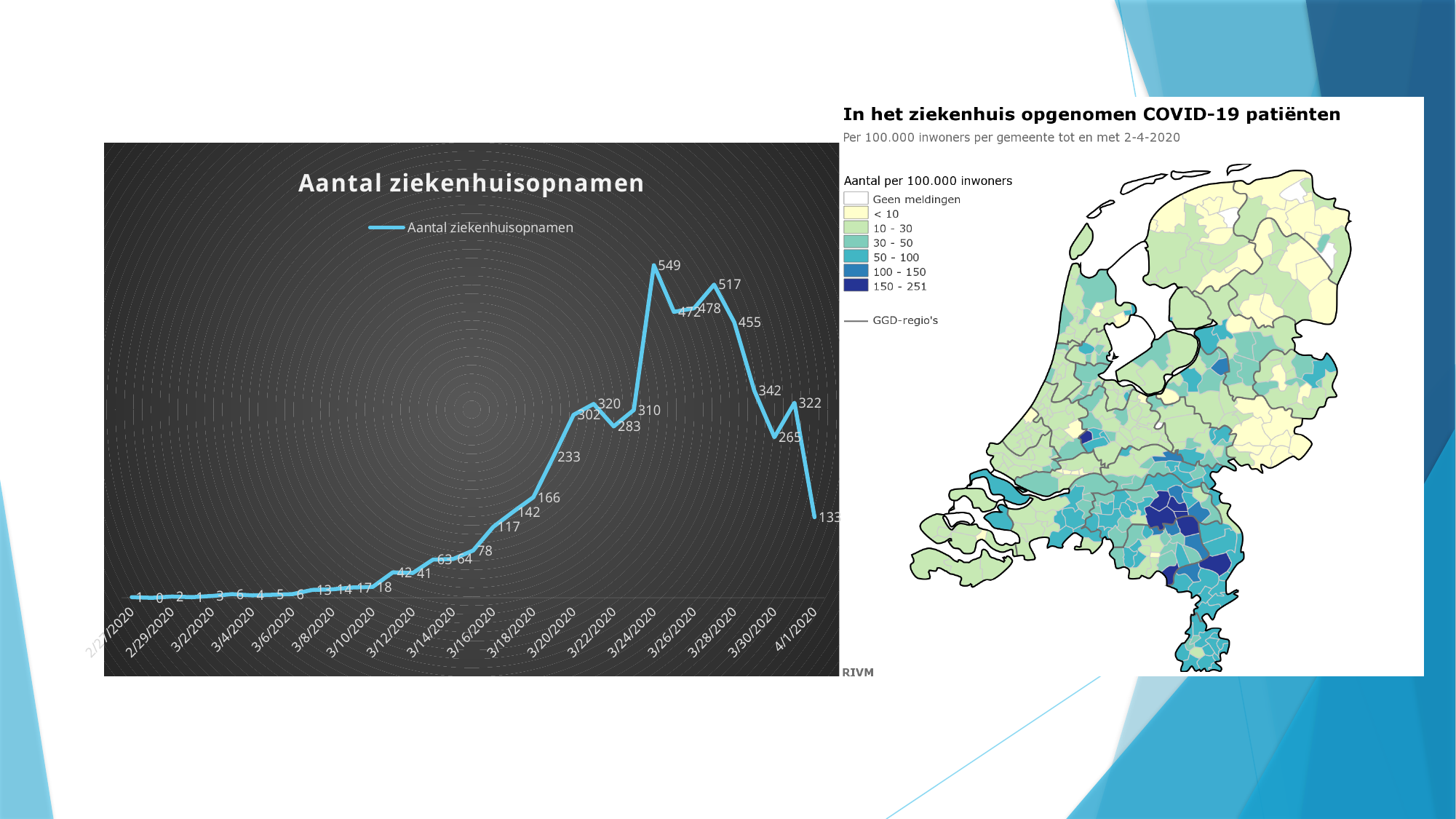
In the 'Aantal ziekenhuisopnamen' chart, what is the difference between the peak value 549 and the later value 517? 32 In the 'Aantal ziekenhuisopnamen' chart, do the values generally rise or fall between 2/27/2020 and 3/24/2020? rise In the 'Aantal ziekenhuisopnamen' chart, what is the value on 4/1/2020? 133 What kind of chart is 'Aantal ziekenhuisopnamen'? line chart What is the title of the line chart on the left of the slide? Aantal ziekenhuisopnamen What is the title of the map on the right of the slide? In het ziekenhuis opgenomen COVID-19 patiënten In the 'Aantal ziekenhuisopnamen' chart, what is the value on 3/24/2020? 549 In the 'Aantal ziekenhuisopnamen' chart, what is the lowest value plotted? 0 In the 'Aantal ziekenhuisopnamen' chart, what is the value on 3/30/2020? 265 How many series does the legend of the 'Aantal ziekenhuisopnamen' chart list? 1 In the 'Aantal ziekenhuisopnamen' chart, which is larger: the value on 3/24/2020 or the value on 3/28/2020? 3/24/2020 In the 'Aantal ziekenhuisopnamen' chart, what is the highest value plotted? 549